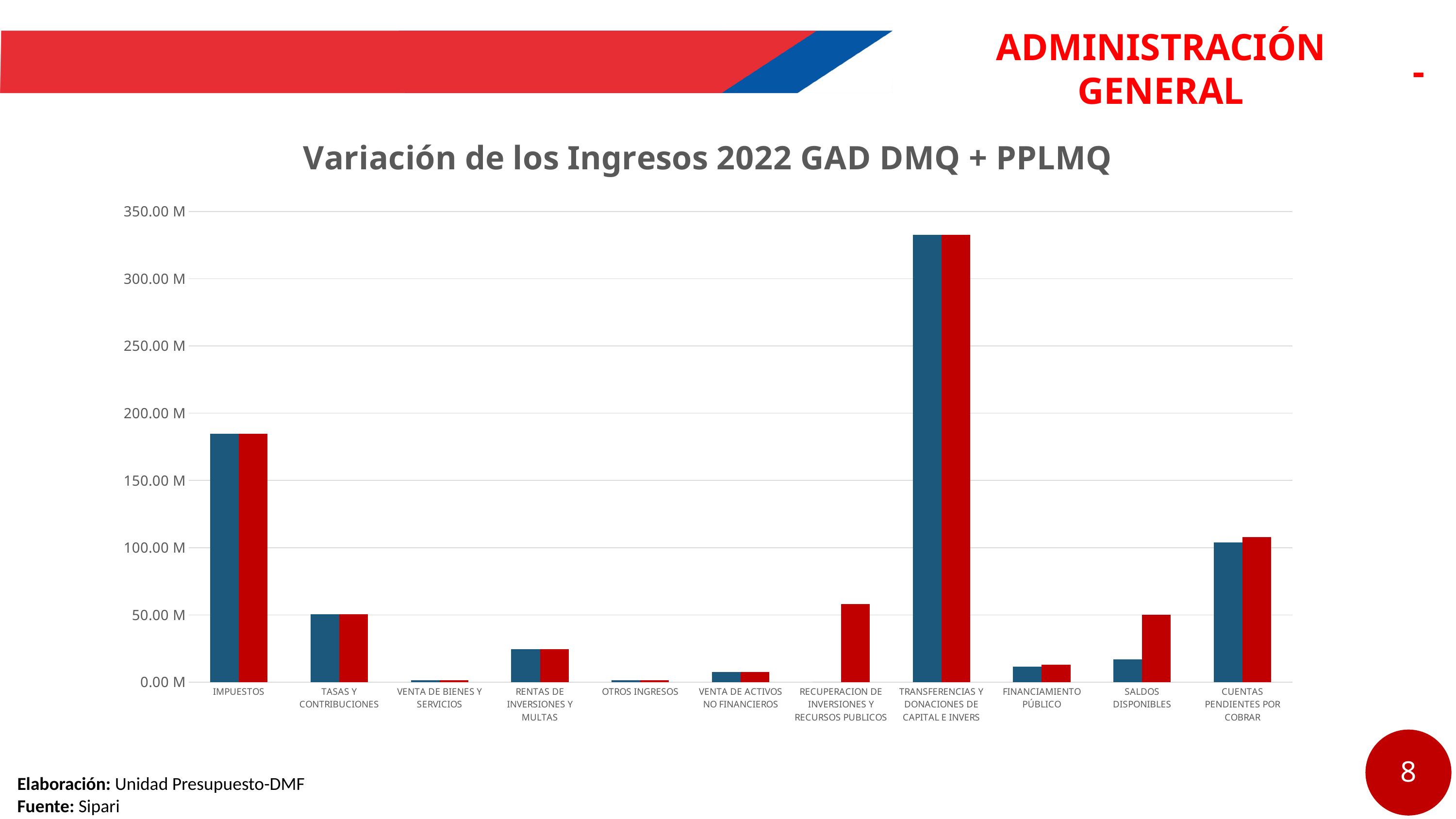
What is the highest value shown on the y axis of the chart? 350.00 M Which category has the highest bars in the chart? TRANSFERENCIAS Y DONACIONES DE CAPITAL E INVERS Which is larger: the blue bar for IMPUESTOS or the blue bar for CUENTAS PENDIENTES POR COBRAR? IMPUESTOS Is the value of the blue bar for SALDOS DISPONIBLES greater or less than 50.00 M? less Is the value of the red bar for TRANSFERENCIAS Y DONACIONES DE CAPITAL E INVERS greater or less than 300.00 M? greater Is the value of the red bar for RECUPERACION DE INVERSIONES Y RECURSOS PUBLICOS greater or less than 50.00 M? greater How many categories are shown on the x axis of the chart? 11 What is the title of the chart? Variación de los Ingresos 2022 GAD DMQ + PPLMQ What kind of chart is shown on the slide? bar chart For SALDOS DISPONIBLES, which bar is larger, the blue one or the red one? the red one